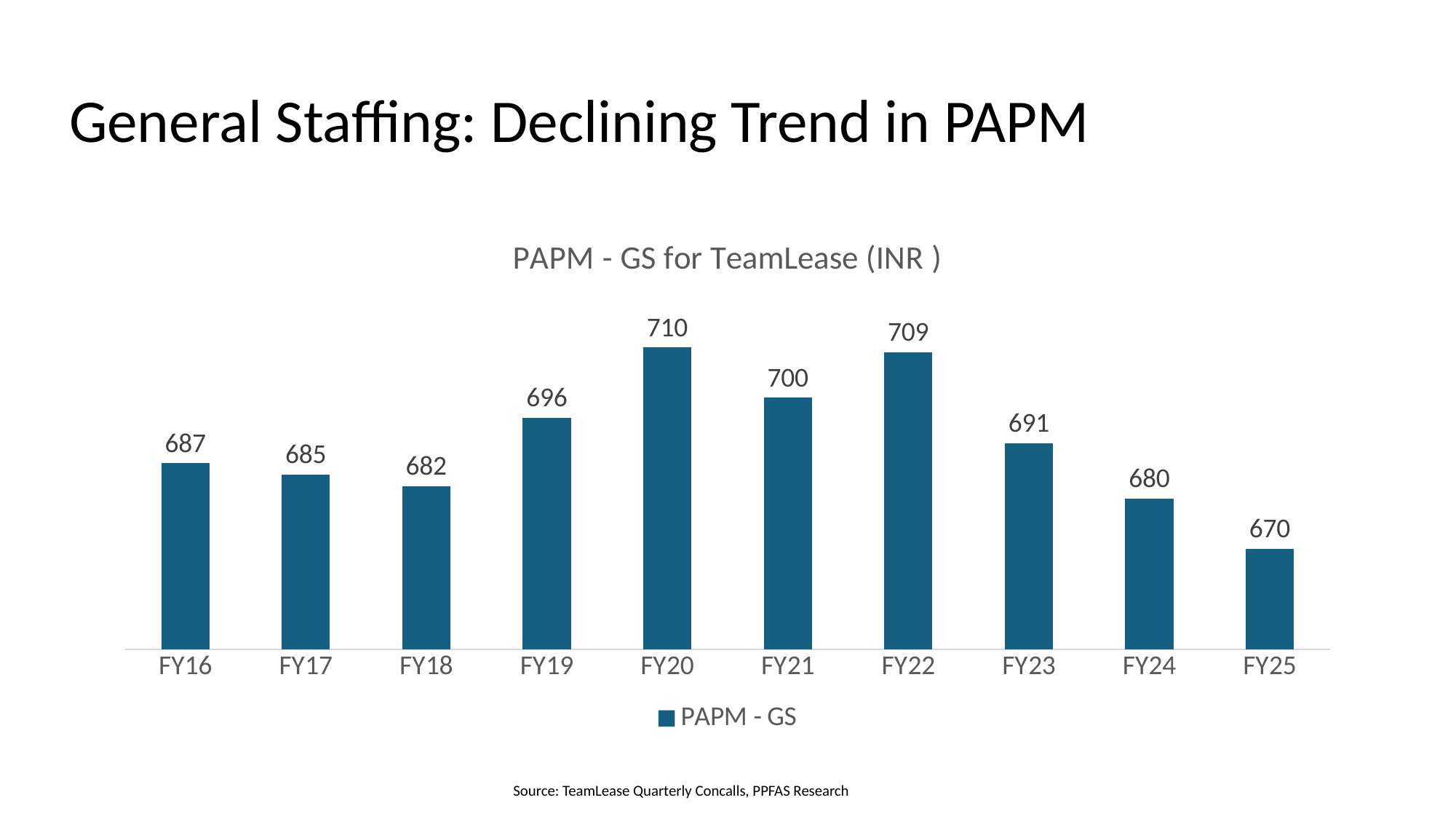
What is the title of the chart? PAPM - GS for TeamLease (INR ) Which fiscal year has the lowest PAPM - GS value? FY25 What is the PAPM - GS value for FY25? 670 What is the PAPM - GS value for FY20? 710 What kind of chart is shown on the slide? Bar chart How many fiscal years are shown on the chart? 10 Which fiscal year has the highest PAPM - GS value? FY20 How many series does the legend list? 1 Which is larger, the PAPM - GS value for FY19 or for FY24? FY19 What is the difference between the PAPM - GS values for FY20 and FY25? 40 What is the difference between the PAPM - GS values for FY22 and FY23? 18 What is the PAPM - GS value for FY18? 682